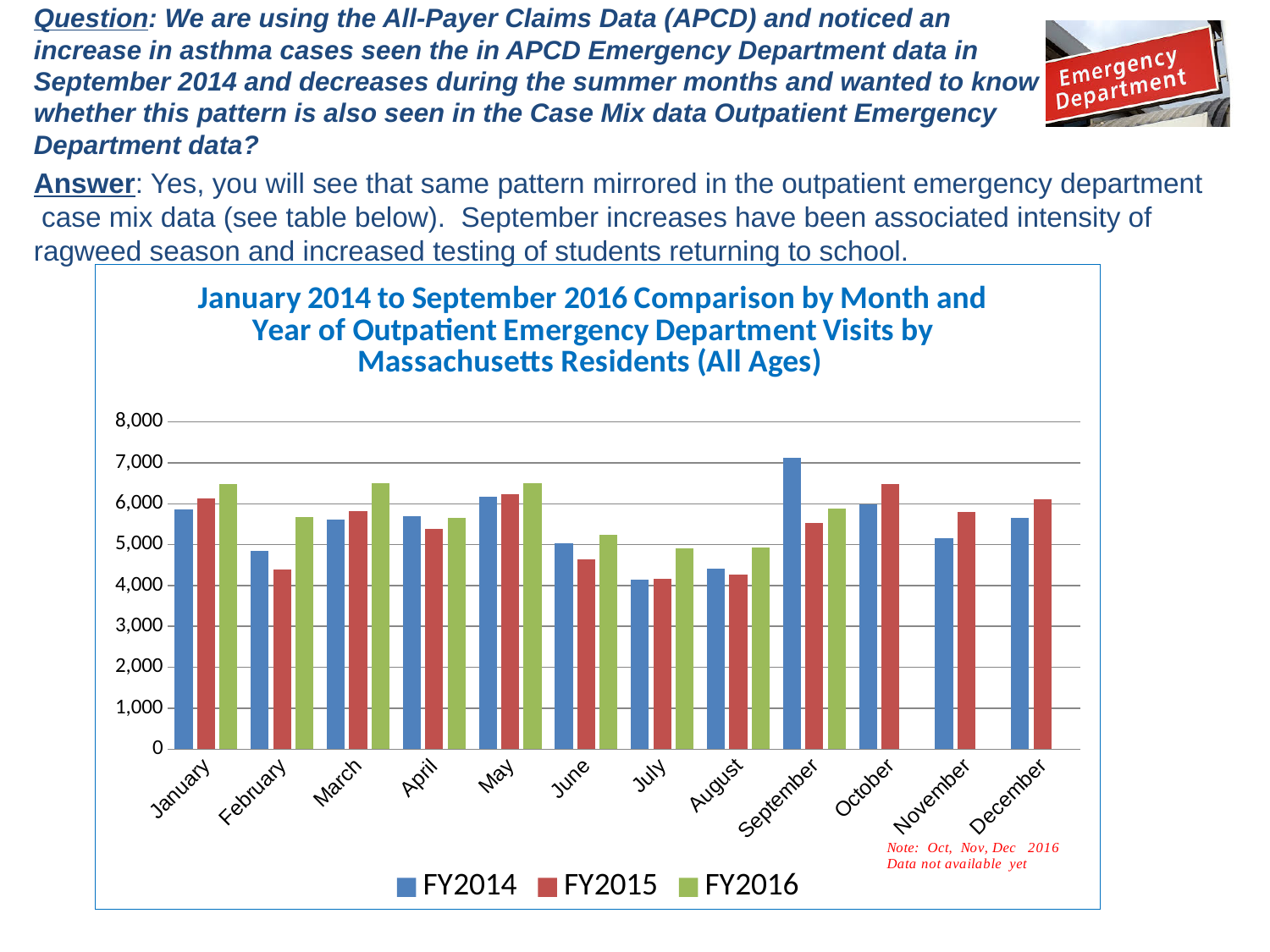
How many series does the legend list? 3 How many months are shown along the x axis? 12 Which month has the lowest FY2014 value? July According to the note on the chart, which months of 2016 have no data available yet? Oct, Nov, Dec In February, which is larger, the FY2015 value or the FY2016 value? FY2016 In October, which is larger, the FY2014 value or the FY2015 value? FY2015 Is the FY2014 value for September greater or less than 6,000? greater What kind of chart is shown on the slide? Bar chart In September, which is larger, the FY2014 value or the FY2015 value? FY2014 Is the FY2015 value for February greater or less than 5,000? less Is the FY2014 value for November greater or less than 6,000? less Which month has the highest FY2014 value? September